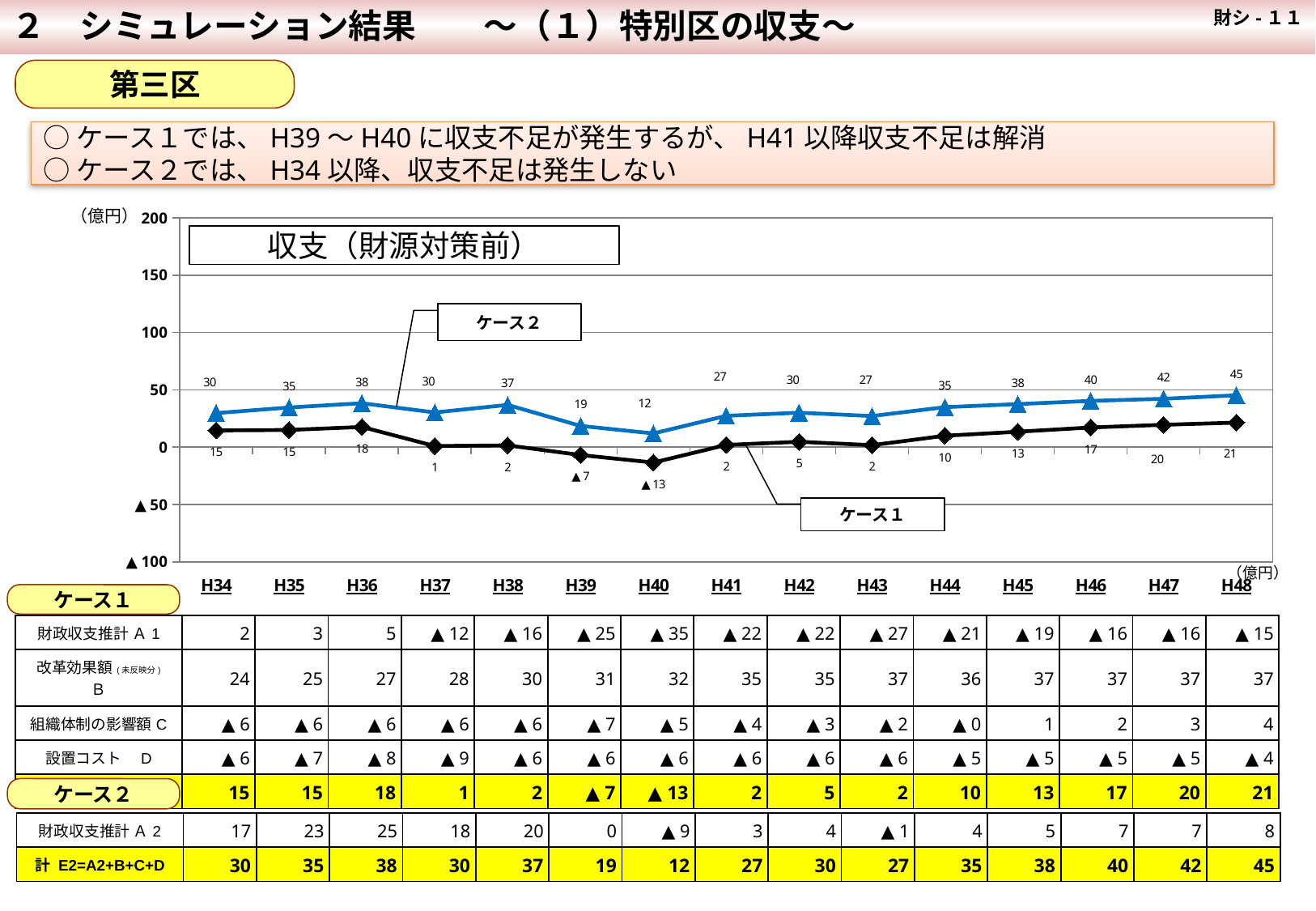
In which year does ケース1 reach its lowest value? H40 Do the values of ケース2 rise or fall from H44 to H48? rise What is the value of ケース2 at H48? 45 What is the value of ケース1 at H40? ▲13 What type of chart is shown on the slide? line chart What is the value of ケース2 at H40? 12 What is the title of the chart? 収支（財源対策前） How many years (data points) are plotted along the x axis of the chart? 15 In which year does ケース2 reach its highest value? H48 Which series has the higher value at H39, ケース1 or ケース2? ケース2 What is the difference between ケース2 and ケース1 at H36? 20 How many series are plotted in the chart? 2